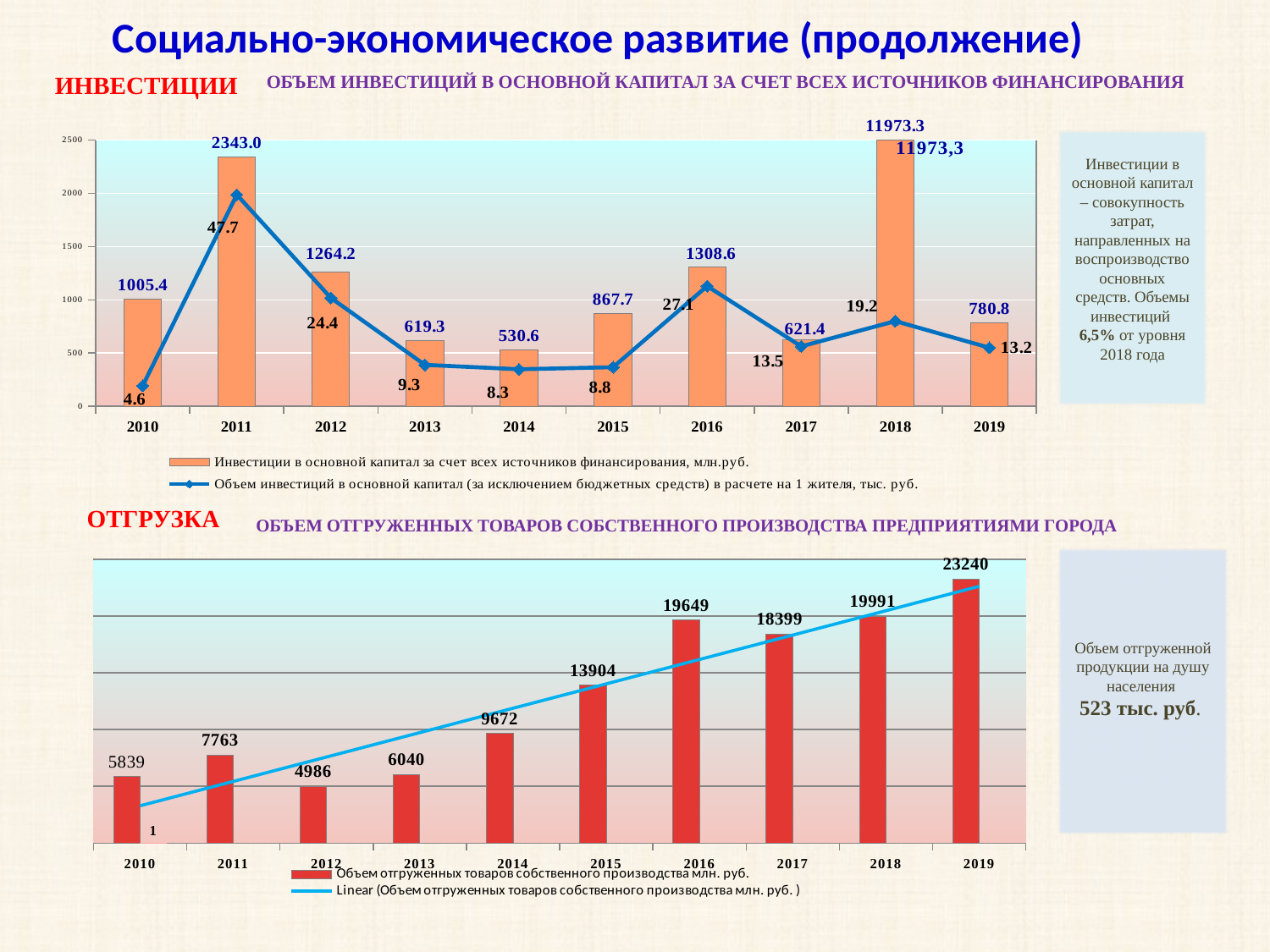
In the bottom chart (ОБЪЕМ ОТГРУЖЕННЫХ ТОВАРОВ), which year has the highest value? 2019 In the top chart (ОБЪЕМ ИНВЕСТИЦИЙ В ОСНОВНОЙ КАПИТАЛ), what is the value of the line series (per resident) for 2016? 27.1 In the top chart (ОБЪЕМ ИНВЕСТИЦИЙ В ОСНОВНОЙ КАПИТАЛ), how many series does the legend list? 2 In the top chart (ОБЪЕМ ИНВЕСТИЦИЙ В ОСНОВНОЙ КАПИТАЛ), what is the difference between the bar values for 2012 and 2013? 644.9 In the bottom chart (ОБЪЕМ ОТГРУЖЕННЫХ ТОВАРОВ), which year has the lowest value? 2012 In the top chart (ОБЪЕМ ИНВЕСТИЦИЙ В ОСНОВНОЙ КАПИТАЛ), which year has the highest value of the line series? 2011 In the top chart (ОБЪЕМ ИНВЕСТИЦИЙ В ОСНОВНОЙ КАПИТАЛ), which year has the lowest bar value? 2014 In the bottom chart (ОБЪЕМ ОТГРУЖЕННЫХ ТОВАРОВ), which is larger, the value for 2016 or the value for 2017? 2016 In the top chart (ОБЪЕМ ИНВЕСТИЦИЙ В ОСНОВНОЙ КАПИТАЛ), what is the value of the bar for 2011? 2343.0 In the bottom chart (ОБЪЕМ ОТГРУЖЕННЫХ ТОВАРОВ), how many years are shown on the x axis? 10 In the bottom chart (ОБЪЕМ ОТГРУЖЕННЫХ ТОВАРОВ), what is the value for 2015? 13904 In the bottom chart (ОБЪЕМ ОТГРУЖЕННЫХ ТОВАРОВ), what is the difference between the values for 2019 and 2018? 3249